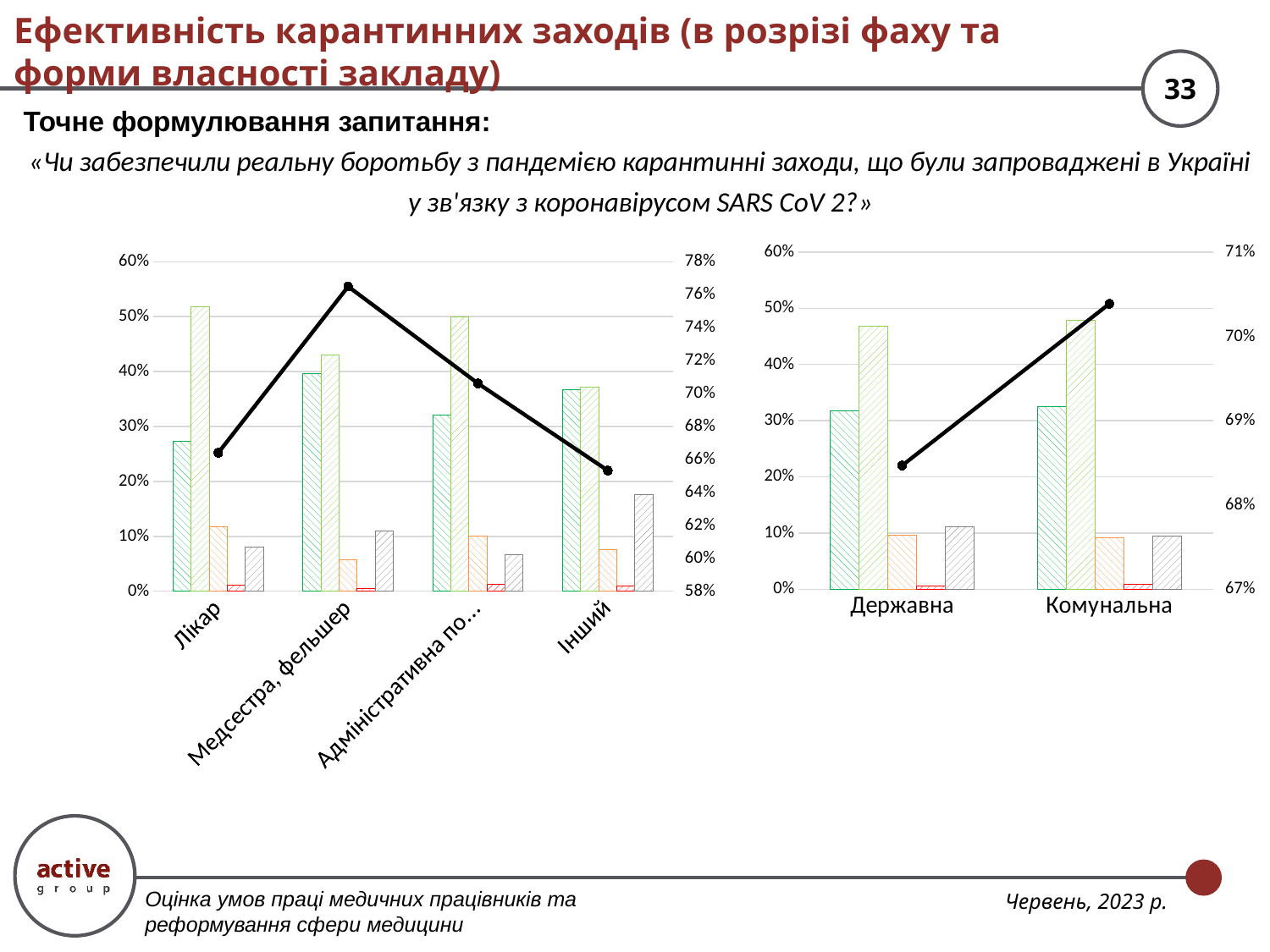
In the right chart, does the black line rise or fall from Державна to Комунальна? Rises In the right chart, is the black line value for Комунальна greater or less than 69% on the right-hand axis? greater In the left chart, which category has the taller light green hatched bar: Лікар or Медсестра, фельшер? Лікар In the right chart, how many bars are plotted for each category? 5 In the left chart, is the light green hatched bar for Лікар greater or less than 50%? greater In the right chart, how many categories are shown on the x axis? 2 In the left chart, which category has the taller gray hatched bar: Інший or Лікар? Інший In the left chart, for which category does the black line reach its highest point? Медсестра, фельшер What kind of chart is the right chart? Combined bar and line chart In the right chart, is the light green hatched bar for Державна greater or less than 40%? greater In the left chart, how many categories are shown on the x axis? 4